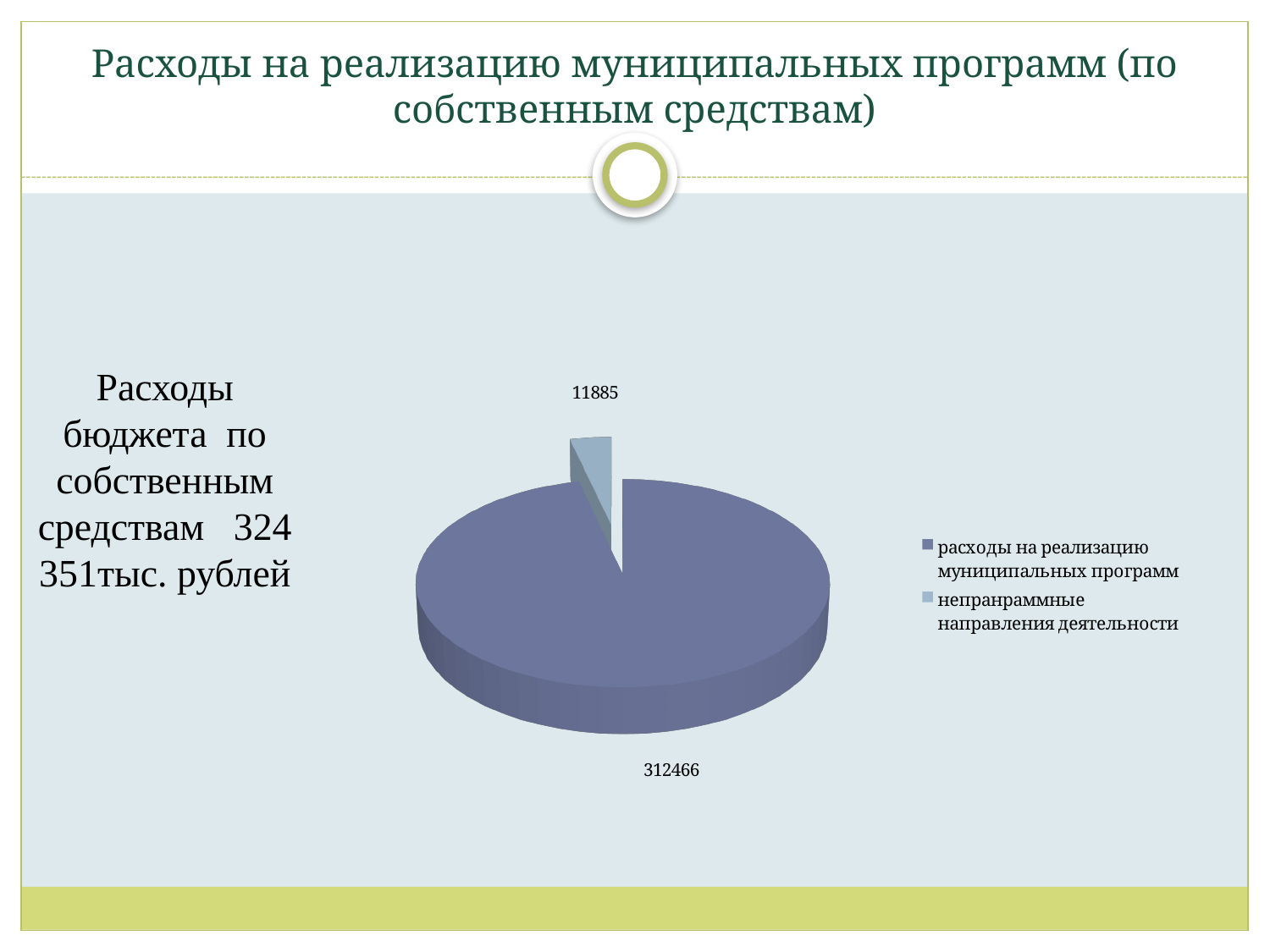
What is the value for непранраммные направления деятельности? 11885 Which category has the largest slice of the pie? расходы на реализацию муниципальных программ How many slices does the pie chart have? 2 What colour is the slice for расходы на реализацию муниципальных программ? dark blue How many entries does the legend list? 2 Which category has the smallest slice of the pie? непранраммные направления деятельности Which is larger: расходы на реализацию муниципальных программ or непранраммные направления деятельности? расходы на реализацию муниципальных программ What is the value for расходы на реализацию муниципальных программ? 312466 What is the total of the two slices in the pie chart? 324351 What kind of chart is shown on the slide? pie chart What is the difference between the value for расходы на реализацию муниципальных программ and the value for непранраммные направления деятельности? 300581